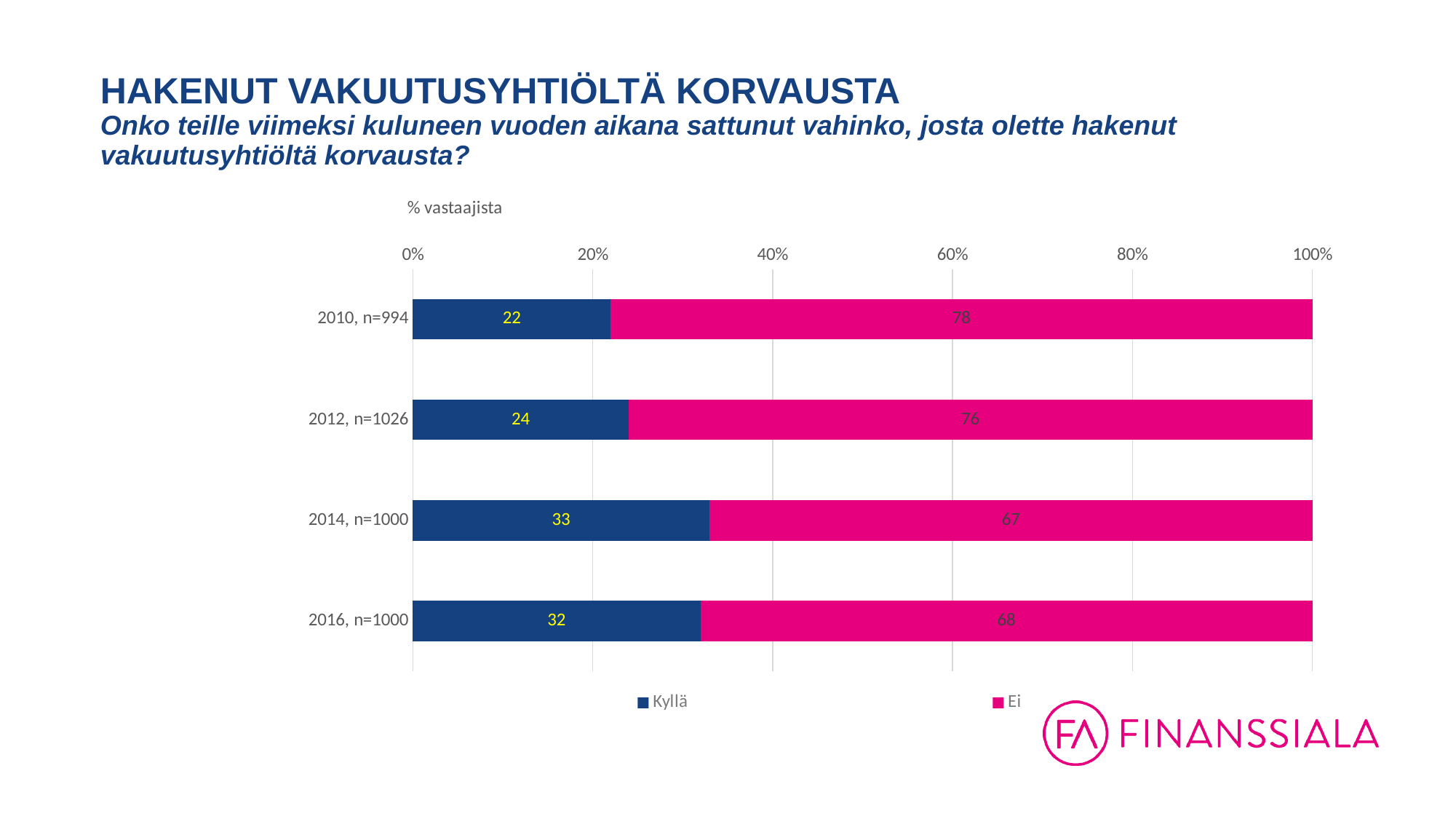
What is the difference between the Kyllä values for 2014, n=1000 and 2010, n=994? 11 What is the value for Kyllä in 2010, n=994? 22 What kind of chart is shown on the slide? Stacked bar chart Which is larger: the Ei value for 2012, n=1026 or the Ei value for 2016, n=1000? 2012, n=1026 What is the total of the stacked bar for 2012, n=1026? 100 Which category has the lowest value for Ei? 2014, n=1000 What is the value for Ei in 2014, n=1000? 67 What is the value for Kyllä in 2016, n=1000? 32 What is the axis label shown above the chart? % vastaajista How many series does the legend list? 2 Which category has the highest value for Kyllä? 2014, n=1000 How many categories are shown on the chart? 4